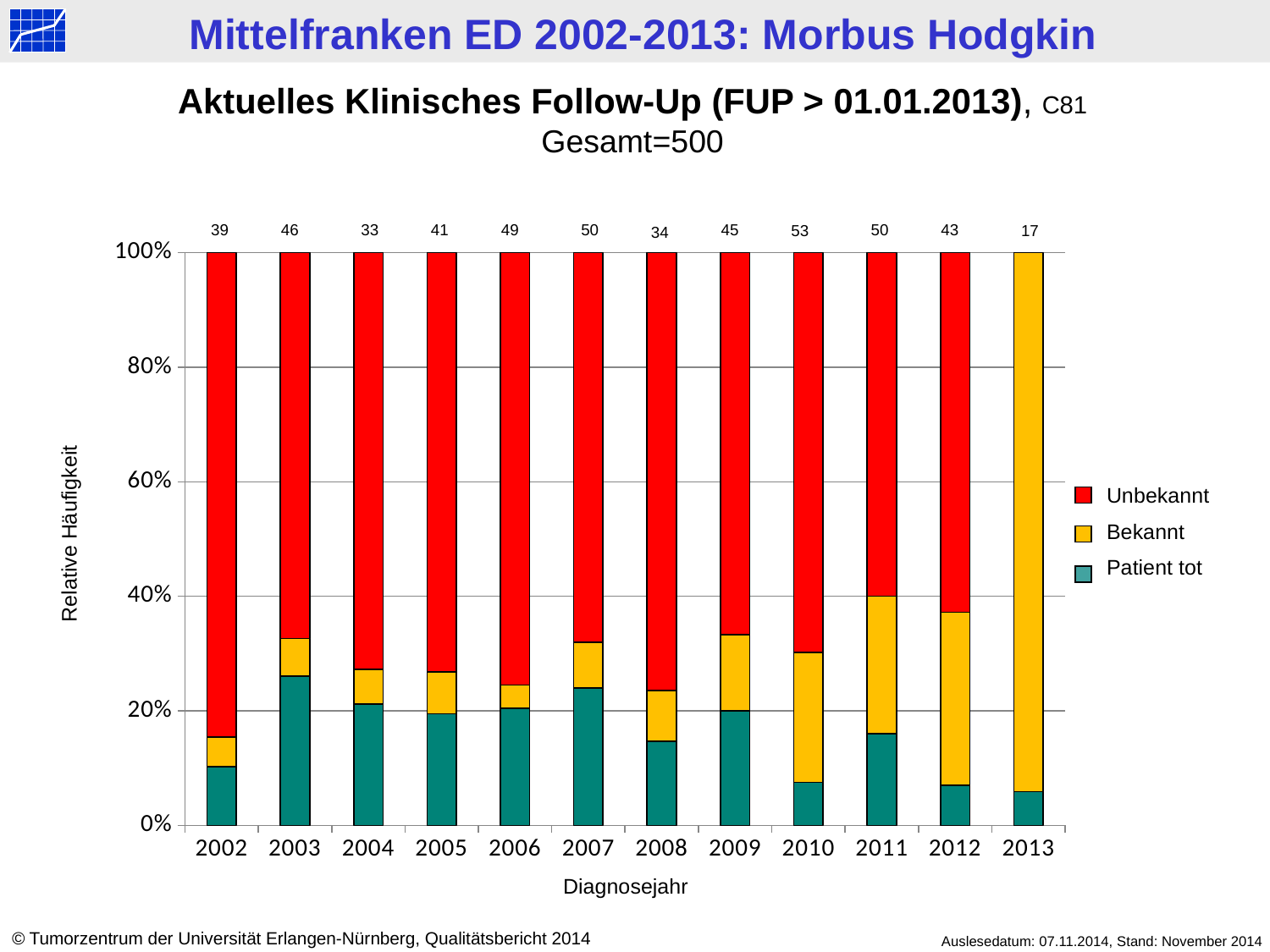
Is the 'Patient tot' share for 2003 greater or less than 20%? greater How many series does the legend list? 3 Is the 'Bekannt' share for 2013 greater or less than 80%? greater Which diagnosis year has the lowest number printed above its bar? 2013 What number is printed above the bar for 2013? 17 What number is printed above the bar for 2006? 49 What is the difference between the numbers printed above the bars for 2010 and 2013? 36 Which year has the larger number printed above its bar, 2003 or 2004? 2003 What is the title of the x axis? Diagnosejahr What number is printed above the bar for 2010? 53 Which diagnosis year has the highest number printed above its bar? 2010 How many diagnosis years are shown on the x axis? 12